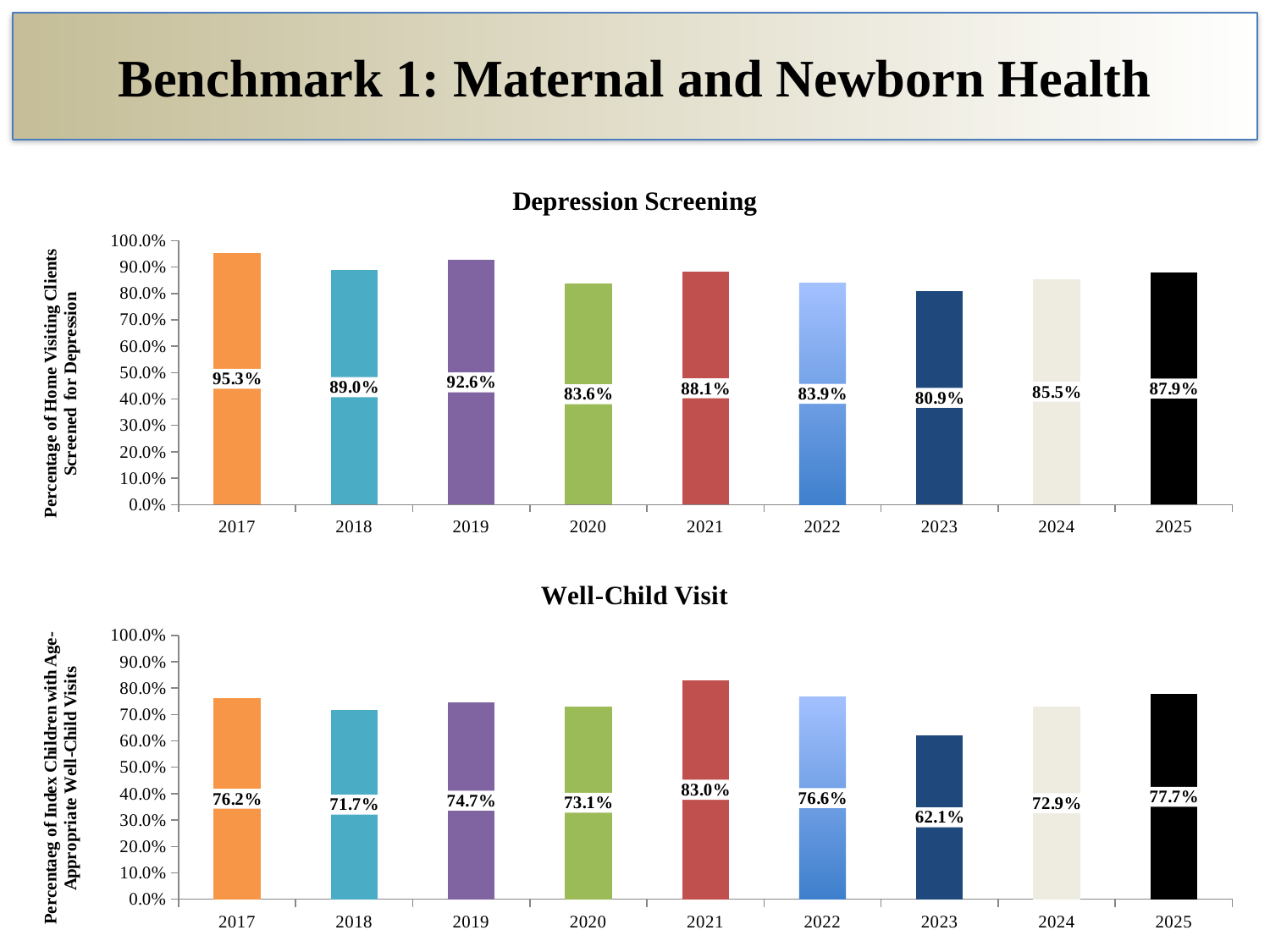
How many years are shown on the x axis of the Depression Screening chart? 9 What kind of chart is the Well-Child Visit chart? bar chart In the Depression Screening chart, which year has the lowest value? 2023 In the Well-Child Visit chart, which year has the highest value? 2021 In the Well-Child Visit chart, is the value for 2021 greater or less than 80.0%? greater In the Depression Screening chart, what is the difference between the 2017 and 2018 values? 6.3% In the Depression Screening chart, what is the value for 2017? 95.3% In the Well-Child Visit chart, what is the value for 2023? 62.1% What is the y-axis label of the Depression Screening chart? Percentage of Home Visiting Clients Screened for Depression In the Well-Child Visit chart, which is larger, the value for 2019 or the value for 2020? 2019 In the Well-Child Visit chart, which year has the lowest value? 2023 In the Depression Screening chart, which year has the highest value? 2017